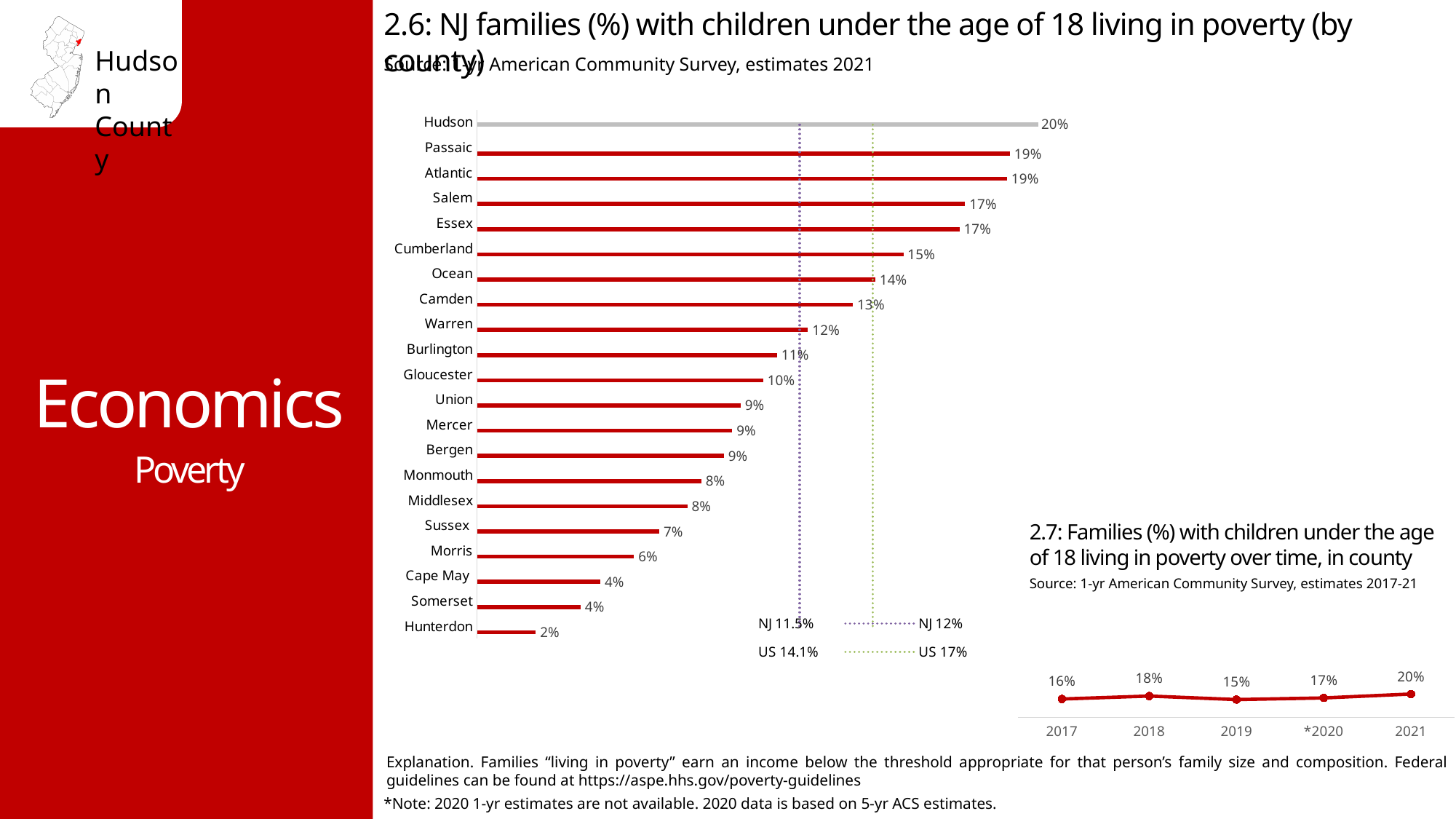
In chart 2.6, what is the value for Cumberland? 15% In chart 2.7, which year has the lowest value? 2019 In chart 2.7, what is the difference between the values for 2021 and 2017? 4% What kind of chart is chart 2.6? Bar chart In chart 2.6, which has a higher value, Camden or Warren? Camden In chart 2.7 (families with children under 18 living in poverty over time), what is the value for 2021? 20% In chart 2.6, which county has the highest value? Hudson In chart 2.6, what is the difference between the values for Hudson and Hunterdon? 18% In chart 2.6 (NJ families with children under 18 living in poverty by county), what is the value for Hudson? 20% In chart 2.6, how many counties are plotted? 21 In chart 2.6, which county has the lowest value? Hunterdon